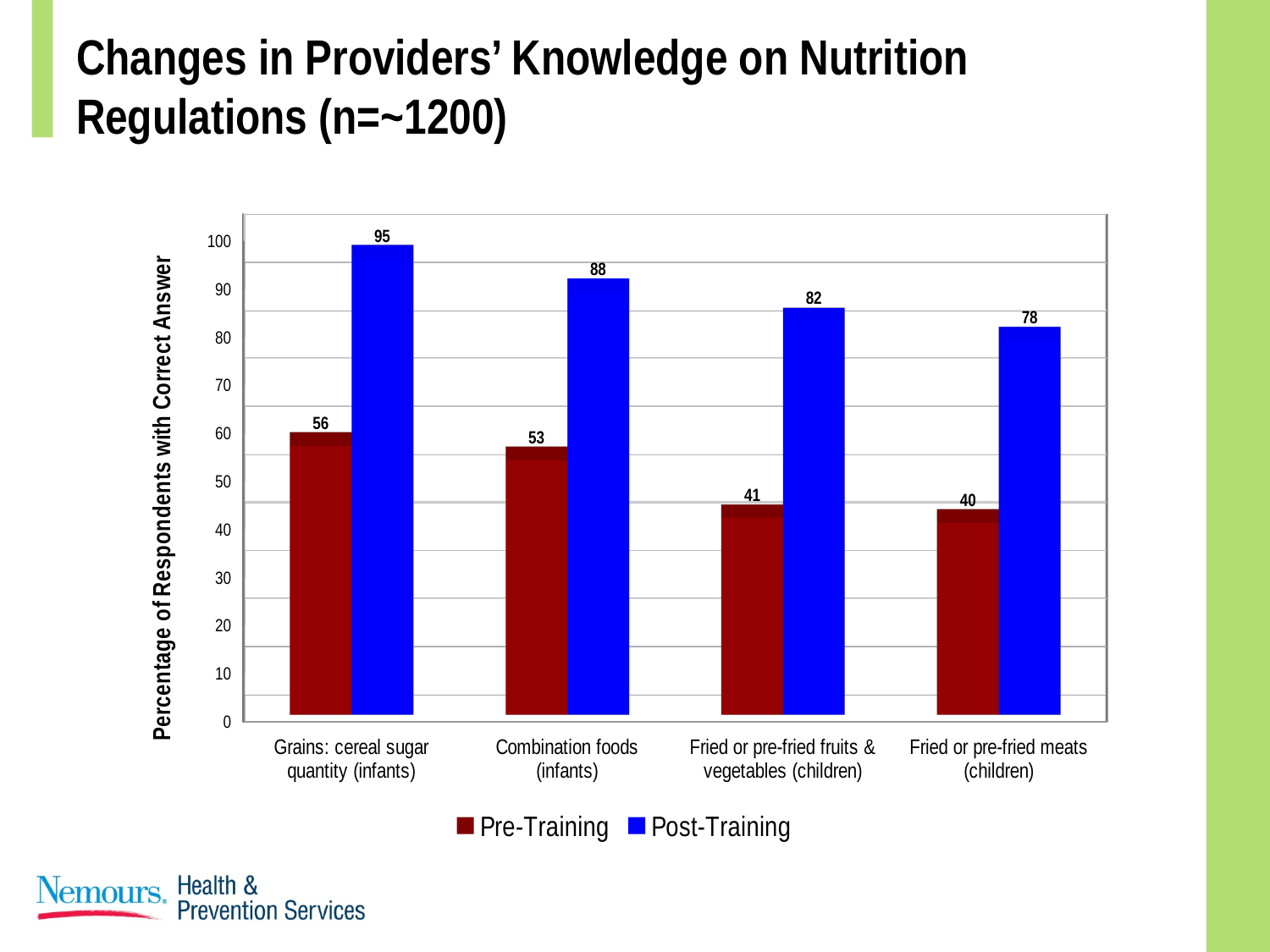
What kind of chart is shown on the slide? Bar chart What is the Pre-Training value for Fried or pre-fried meats (children)? 40 Which category has the lowest Pre-Training value? Fried or pre-fried meats (children) How many series does the legend list? 2 What is the difference between the Post-Training values for Combination foods (infants) and Fried or pre-fried meats (children)? 10 What is the label of the y axis? Percentage of Respondents with Correct Answer What is the difference between the Post-Training and Pre-Training values for Fried or pre-fried fruits & vegetables (children)? 41 What is the Pre-Training value for Combination foods (infants)? 53 Which is larger: the Pre-Training value for Grains: cereal sugar quantity (infants) or the Pre-Training value for Combination foods (infants)? Grains: cereal sugar quantity (infants) What is the Post-Training value for Grains: cereal sugar quantity (infants)? 95 How many categories are shown on the x axis? 4 Which category has the highest Post-Training value? Grains: cereal sugar quantity (infants)